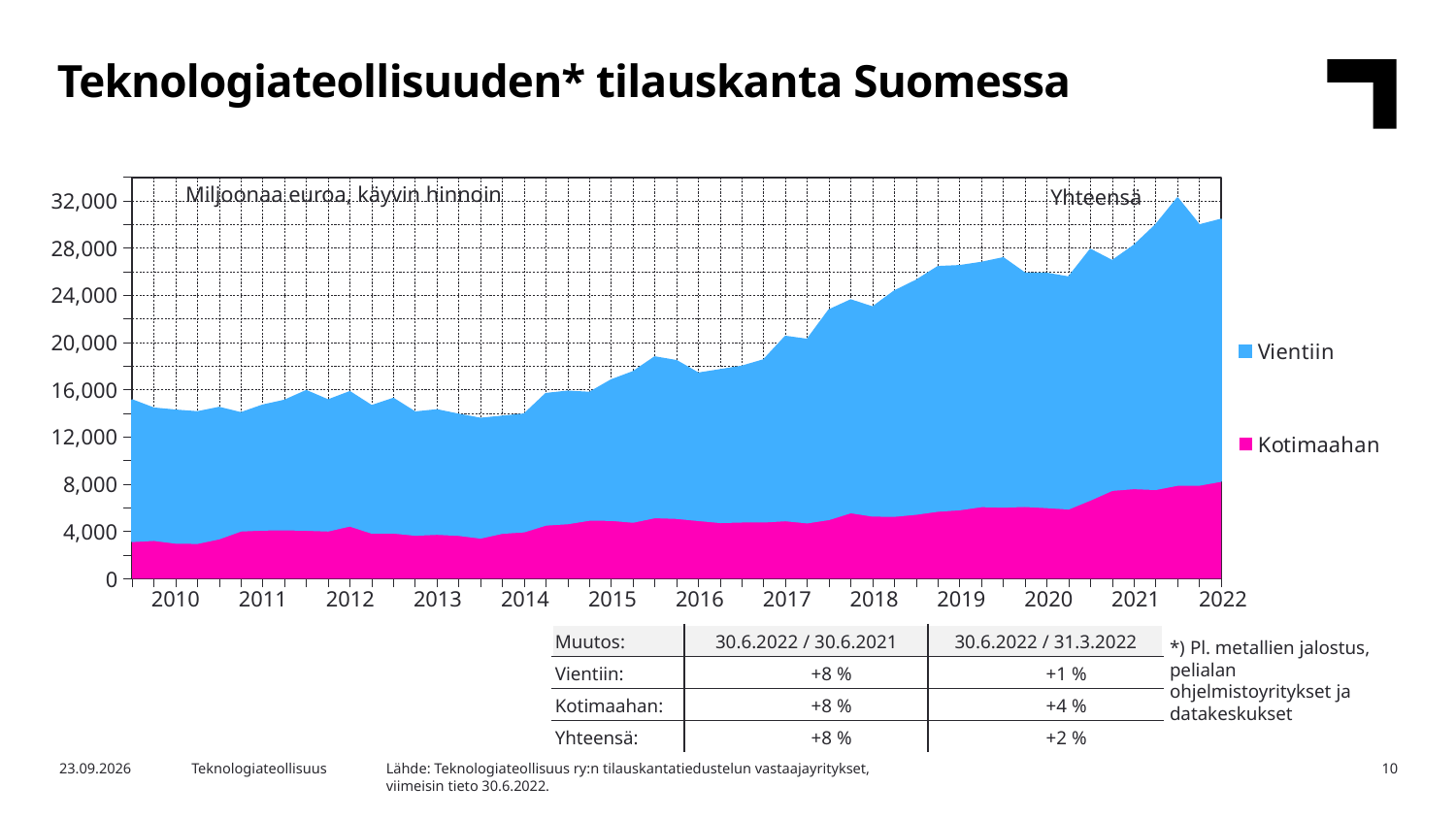
What is the title of the slide? Teknologiateollisuuden* tilauskanta Suomessa Is the total (Yhteensä) value in 2018 greater or less than 20,000? greater Is the Kotimaahan value in 2018 greater or less than 4,000? greater How many series does the legend list? 2 Is the total (Yhteensä) value at the end of 2022 greater or less than 28,000? greater How many year labels are shown on the x axis? 13 Which two series are listed in the chart legend? Vientiin and Kotimaahan Does the total (Yhteensä) value rise or fall overall from 2010 to 2022? rise What kind of chart is shown on the slide? Stacked area chart